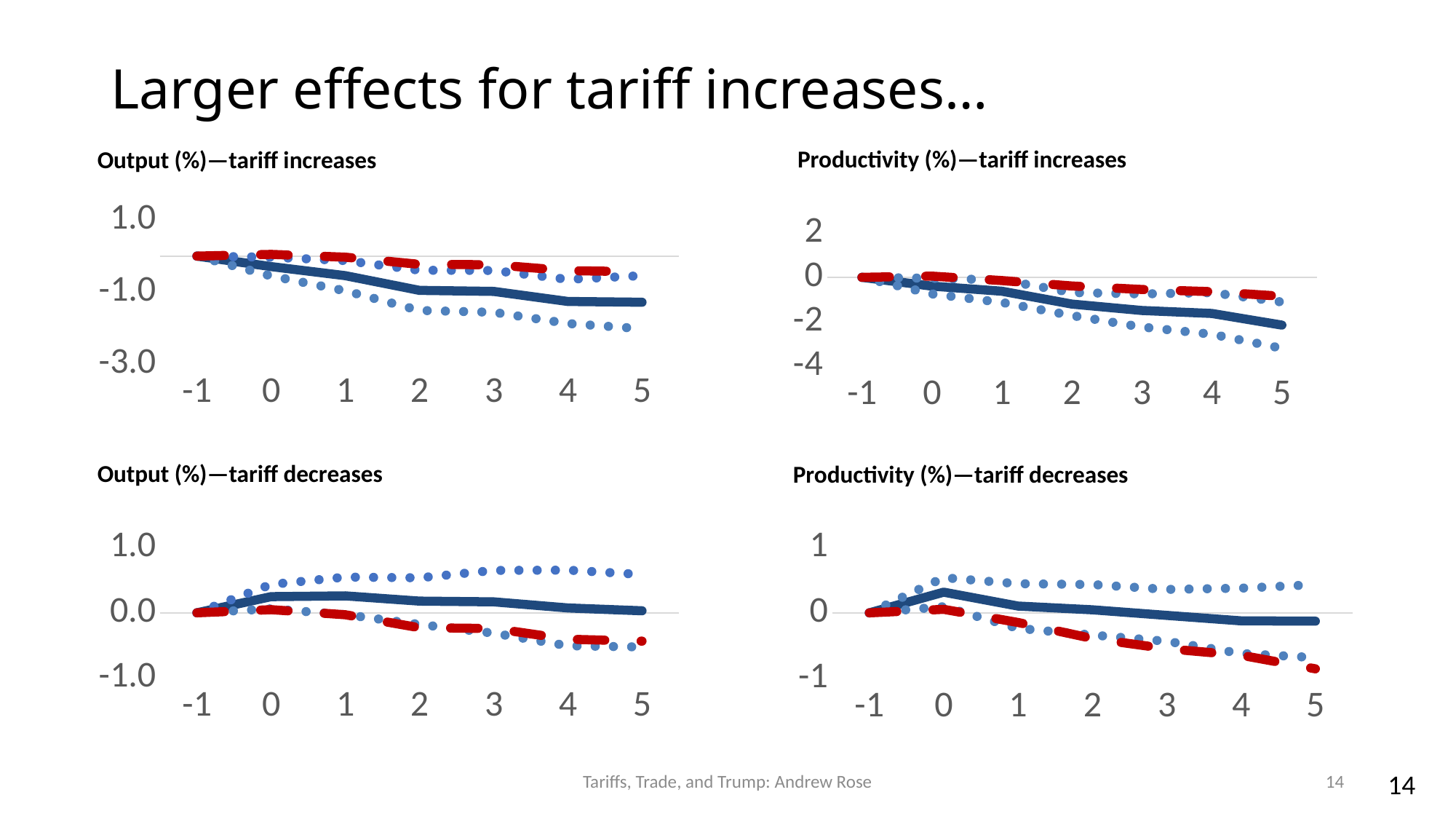
How many points are on the x axis of the 'Productivity (%)—tariff decreases' chart? 7 How many charts are shown on the slide? 4 In the 'Productivity (%)—tariff increases' chart, is the value of the solid line at x = 5 greater or less than 0? less In the 'Output (%)—tariff increases' chart, does the solid line rise or fall from x = -1 to x = 5? fall In the 'Productivity (%)—tariff increases' chart, does the solid line rise or fall from x = -1 to x = 5? fall In the 'Output (%)—tariff decreases' chart, is the value of the solid line at x = 0 greater or less than 0.0? greater In the 'Productivity (%)—tariff increases' chart, is the value of the solid line at x = 5 greater or less than -4? greater What is the title of the chart in the top-right of the slide? Productivity (%)—tariff increases What kind of chart is the 'Output (%)—tariff increases' chart? line chart